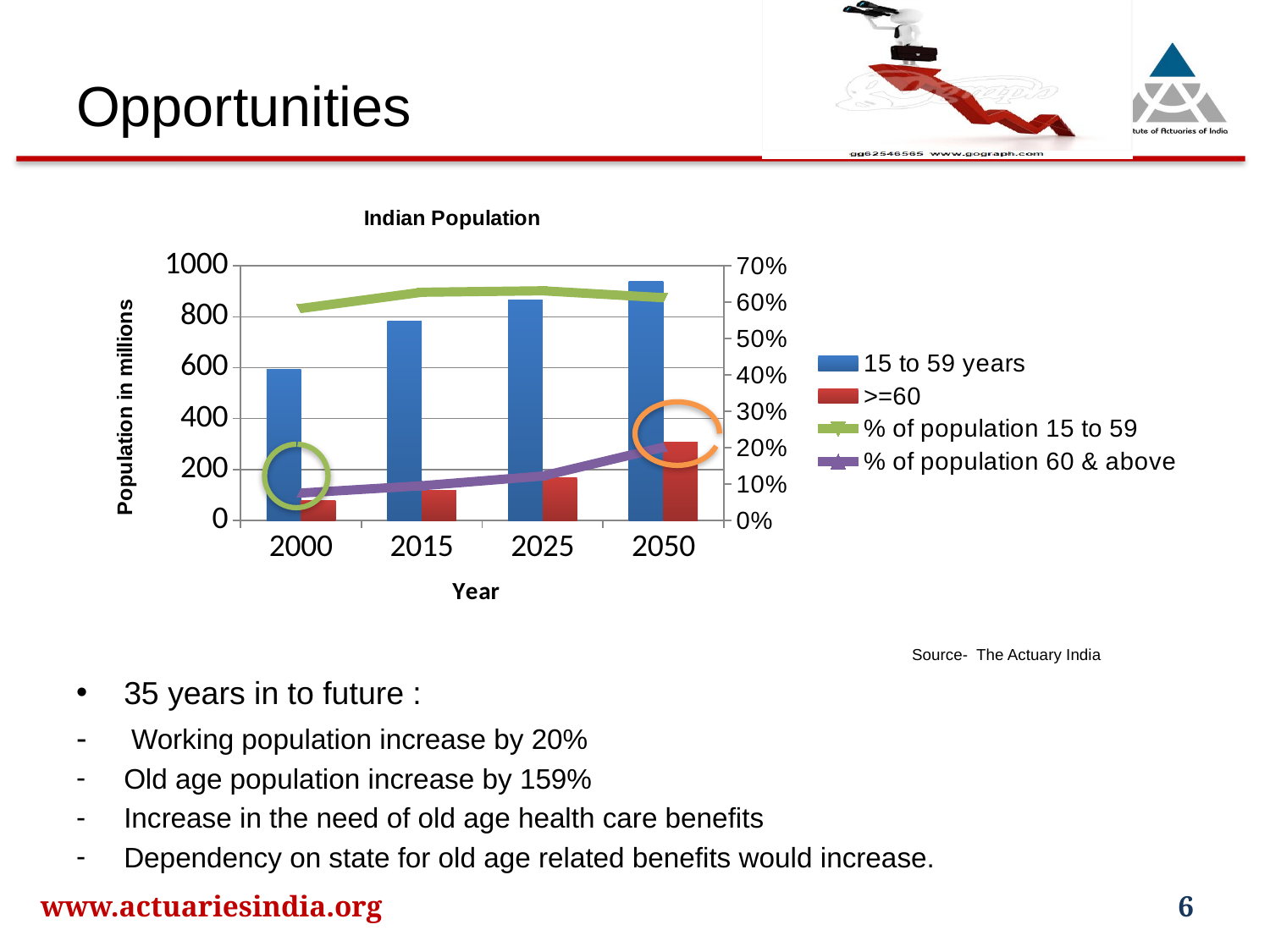
Is the value for >=60 in 2000 greater or less than 200? less In which year is the 15 to 59 years bar the highest? 2050 What is the title of the chart? Indian Population Do the 15 to 59 years bars rise or fall from 2000 to 2050? rise How many series does the chart legend list? 4 In which year is the >=60 bar the highest? 2050 In which year is the 15 to 59 years bar the lowest? 2000 Is the value for 15 to 59 years in 2050 greater or less than 800? greater Is the value for 15 to 59 years in 2015 greater or less than 800? less How many years are shown on the x axis of the chart? 4 What kind of chart is shown on the slide? Combination bar and line chart What is the label of the left vertical axis? Population in millions